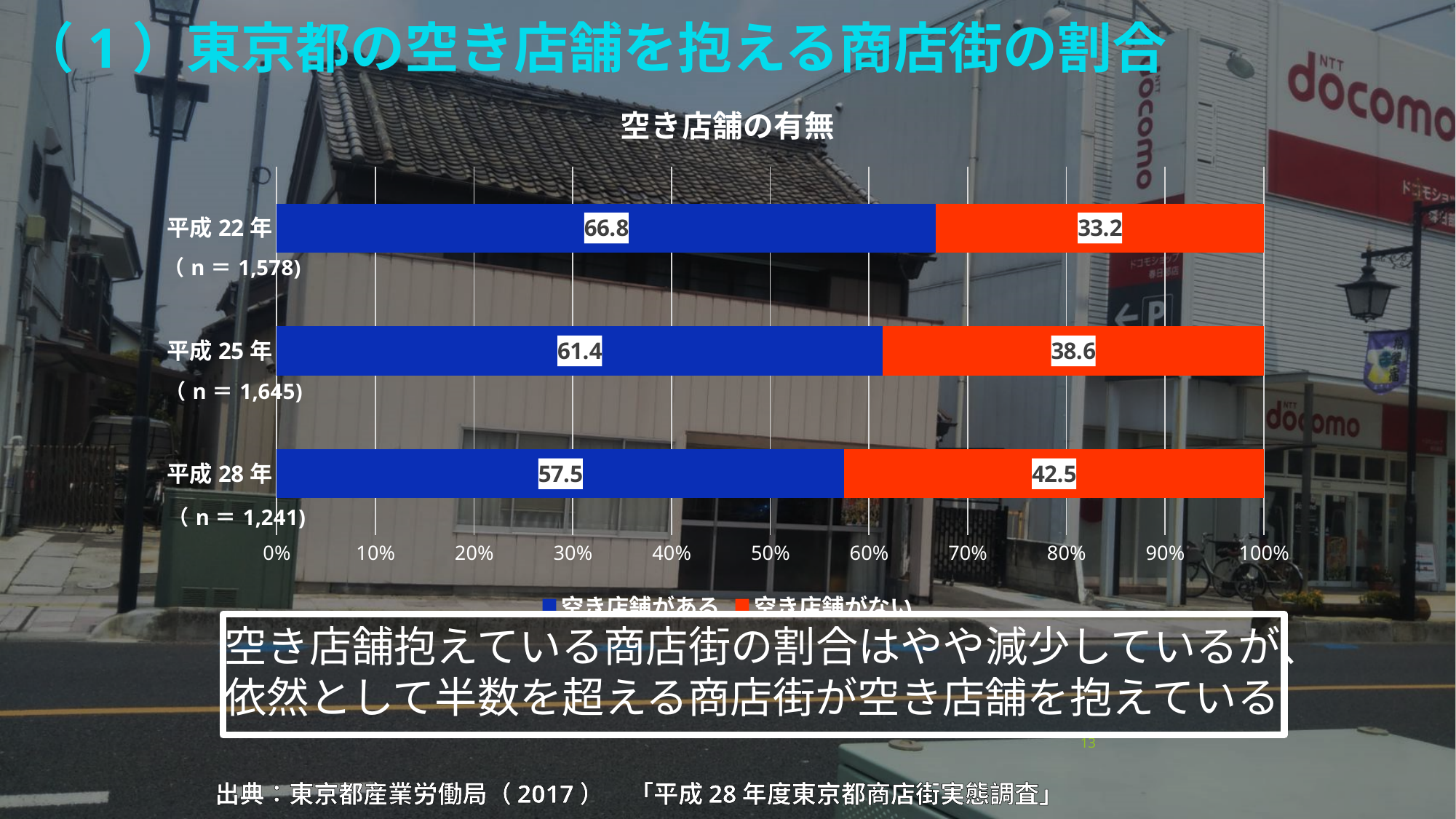
Does the blue (空き店舗がある) segment value rise or fall from 平成22年 to 平成28年? Fall What is the value of the blue (空き店舗がある) segment for 平成22年? 66.8 Which year has the lowest value for the orange (空き店舗がない) segment? 平成22年 Is the blue segment value for 平成25年 larger or smaller than the blue segment value for 平成28年? Larger What is the value of the blue segment for 平成25年? 61.4 What is the difference between the blue segment values for 平成22年 and 平成28年? 9.3 What is the title of the chart? 空き店舗の有無 Which year has the highest value for the blue (空き店舗がある) segment? 平成22年 What kind of chart is shown on the slide? Stacked bar chart How many categories (years) are plotted on the chart? 3 How many series does the chart's legend list? 2 What is the value of the orange (空き店舗がない) segment for 平成28年? 42.5